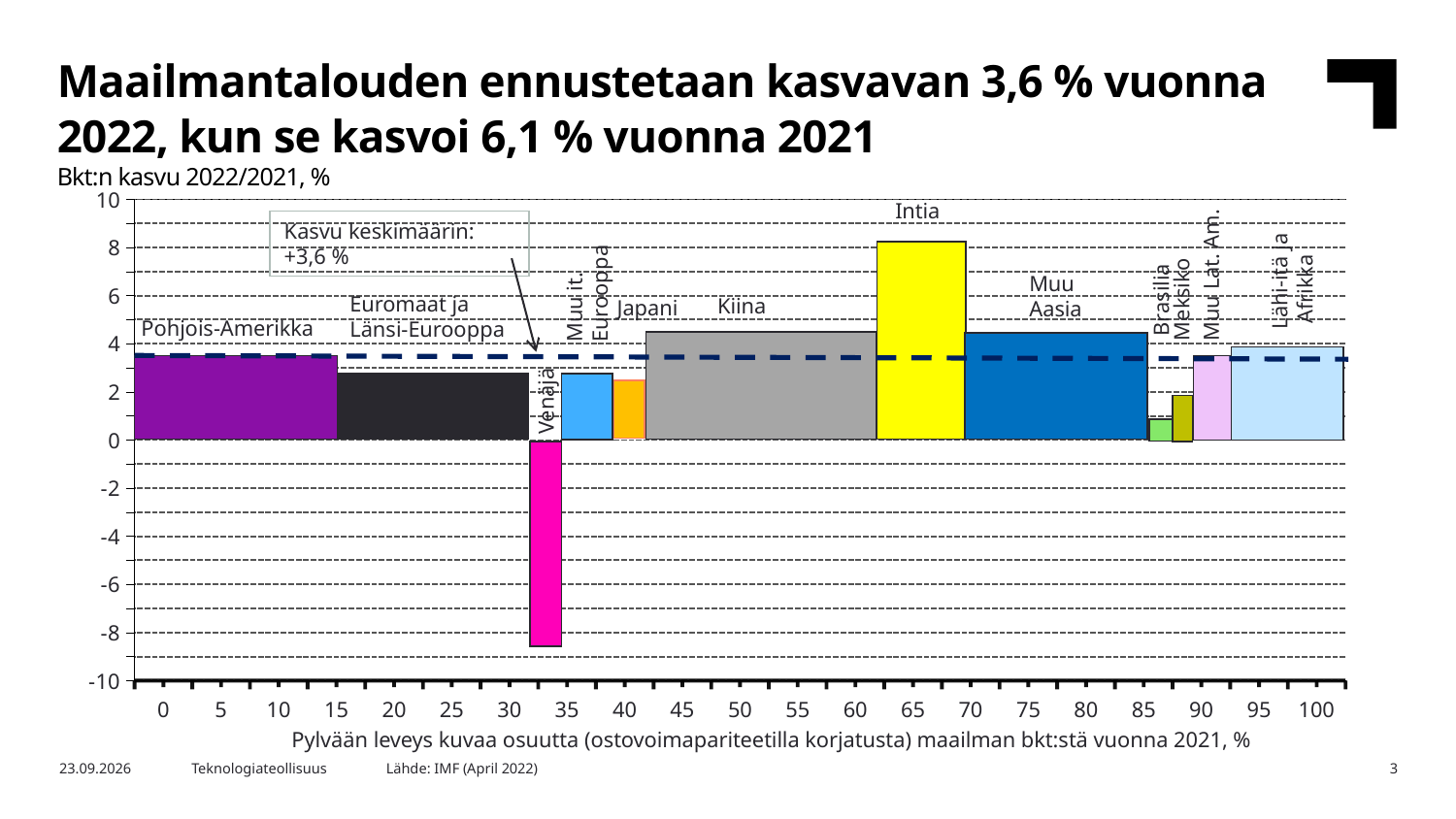
Which has the larger value, Meksiko or Brasilia? Meksiko Which has the larger value, Intia or Kiina? Intia Is the value for Intia greater or less than 6? greater Is the value for Kiina greater or less than 4? greater What average growth does the dashed line annotation in the chart indicate? +3,6 % Is the value for Venäjä greater or less than -6? less What kind of chart is shown on the slide? bar chart How many regions are shown as bars in the chart? 12 Which region has the lowest GDP growth in the chart? Venäjä Which region has the highest GDP growth in the chart? Intia